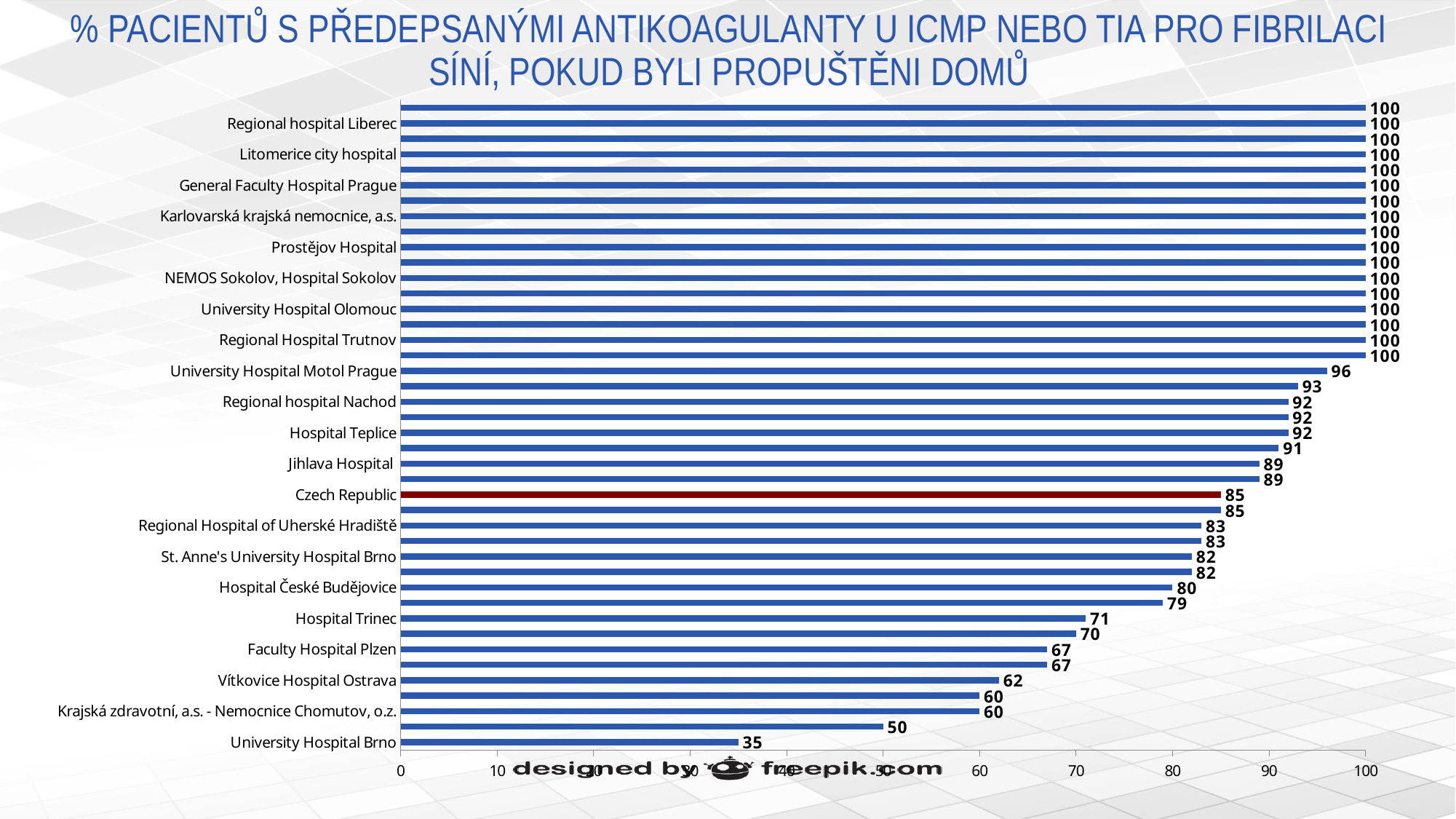
What is the value for University Hospital Brno? 35 What is the value for Czech Republic? 85 What is the value for Regional hospital Nachod? 92 What is the difference between the value for Czech Republic and the value for University Hospital Brno? 50 Which category has the lowest value? University Hospital Brno Do the values increase or decrease going from the top bar to the bottom bar? decrease What is the value for Hospital Trinec? 71 What is the value for University Hospital Motol Prague? 96 Which is larger, the value for University Hospital Motol Prague or the value for Hospital Teplice? University Hospital Motol Prague Is the value for Faculty Hospital Plzen greater or less than 70? less Which category's bar is drawn in a different colour (red) from the others? Czech Republic What kind of chart is shown on the slide? bar chart